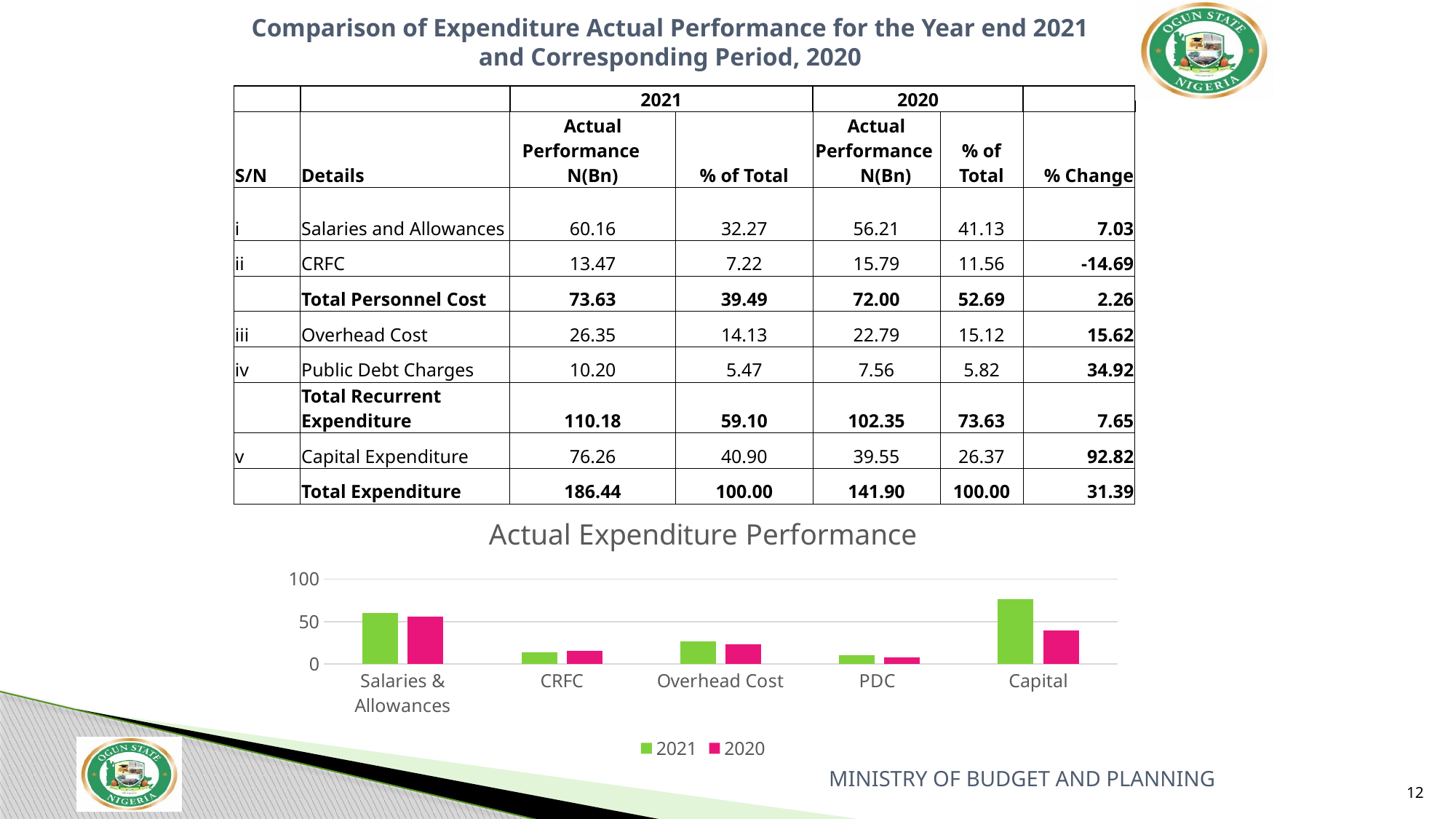
In the "Actual Expenditure Performance" chart, is the 2020 value for Capital greater or less than 50? less In the "Actual Expenditure Performance" chart, which category has the lowest 2020 bar? PDC In the "Actual Expenditure Performance" chart, is the 2021 value for Capital greater or less than 50? greater In the "Actual Expenditure Performance" chart, which category has the highest 2021 bar? Capital In the "Actual Expenditure Performance" chart, which category has the highest 2020 bar? Salaries & Allowances In the "Actual Expenditure Performance" chart, for Capital, which series has the larger bar, 2021 or 2020? 2021 In the "Actual Expenditure Performance" chart, is the 2021 value for Overhead Cost greater or less than 50? less What colour are the 2021 bars in the "Actual Expenditure Performance" chart? green What kind of chart is shown under the title "Actual Expenditure Performance"? bar chart How many categories are shown on the x axis of the "Actual Expenditure Performance" chart? 5 How many series does the legend of the "Actual Expenditure Performance" chart list? 2